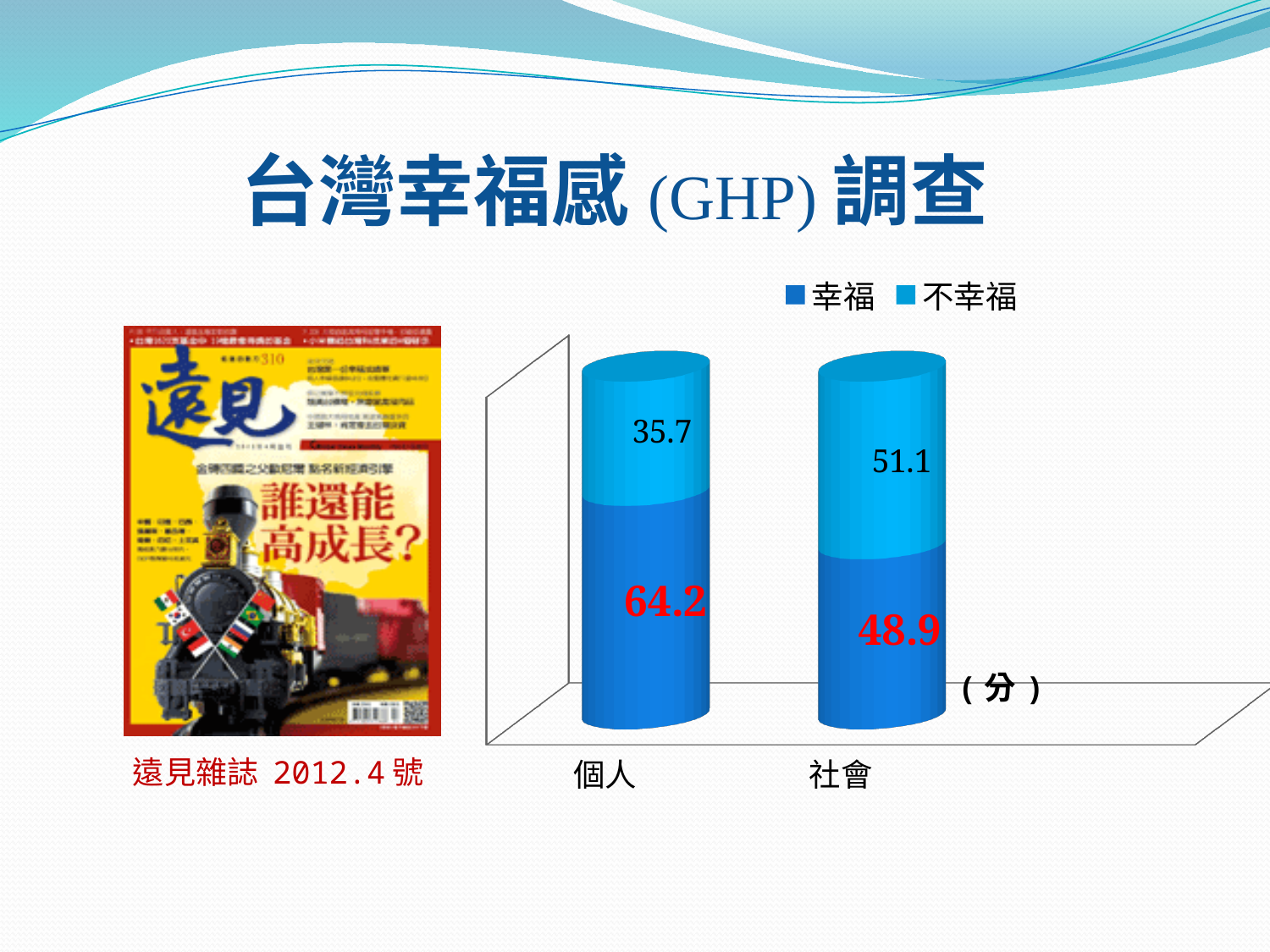
What kind of chart is shown on the slide? Stacked bar chart What is the 幸福 value for 個人? 64.2 Which category has the lowest 不幸福 value? 個人 Which category has the higher 幸福 value, 個人 or 社會? 個人 What is the 不幸福 value for 社會? 51.1 How many series does the legend list? 2 What is the 幸福 value for 社會? 48.9 What is the difference between the 不幸福 values for 社會 and 個人? 15.4 How many categories are shown on the x axis? 2 What is the total of the stacked bar for 個人? 99.9 What is the 不幸福 value for 個人? 35.7 What is the difference between the 幸福 values for 個人 and 社會? 15.3